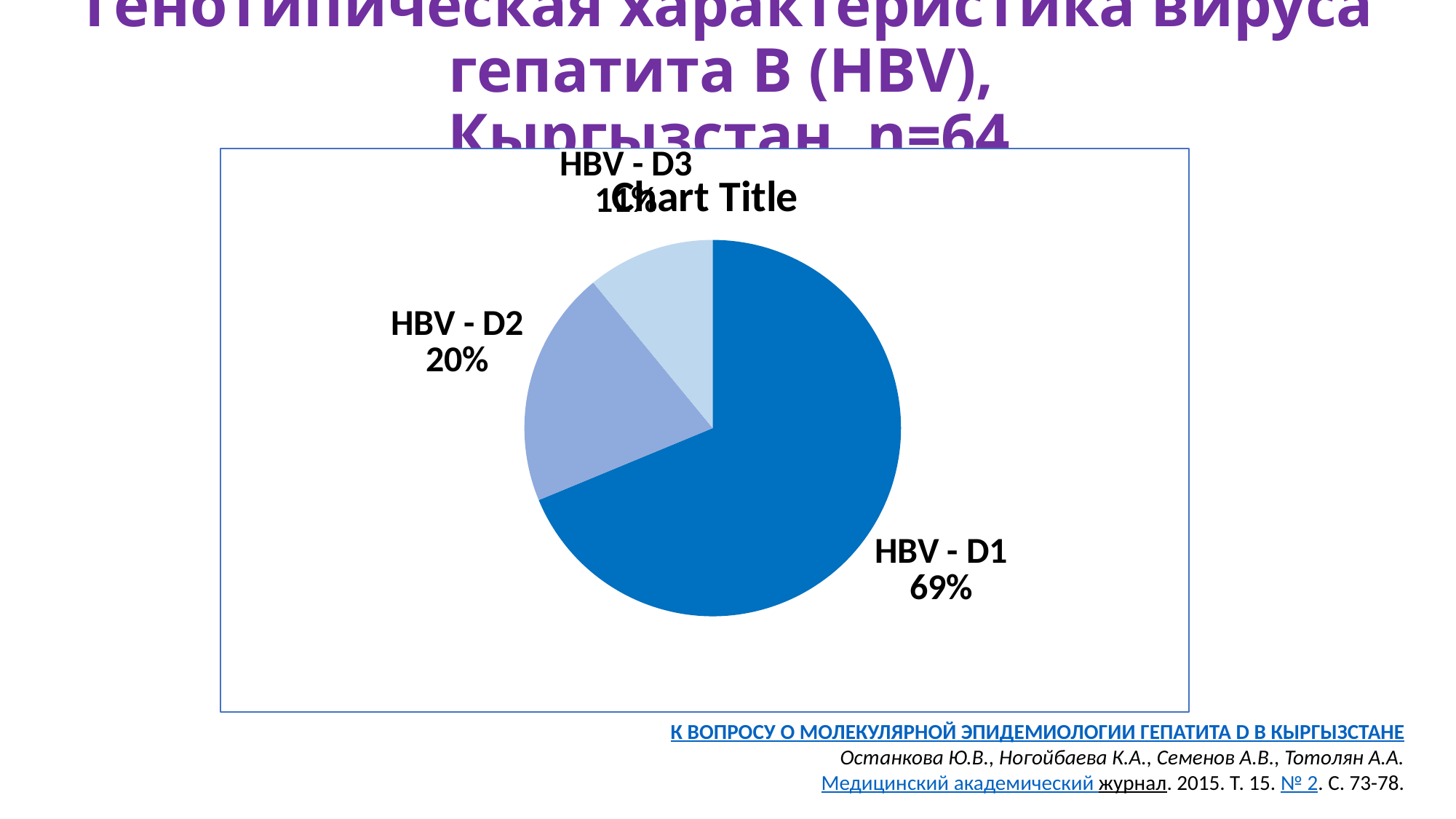
How many slices does the pie chart have? 3 Which genotype has the largest slice of the pie? HBV - D1 Which slice is larger, HBV - D2 or HBV - D3? HBV - D2 What share of the pie does HBV - D2 account for? 20% What colour is the HBV - D1 slice? dark blue By how many percentage points does the HBV - D1 share exceed the HBV - D2 share? 49 Is the share for HBV - D1 greater or less than 50%? greater What kind of chart is shown on the slide? pie chart Which slice is larger, HBV - D1 or HBV - D2? HBV - D1 What share of the pie does HBV - D1 account for? 69% What title is printed above the pie chart? Chart Title Which genotype has the smallest slice of the pie? HBV - D3